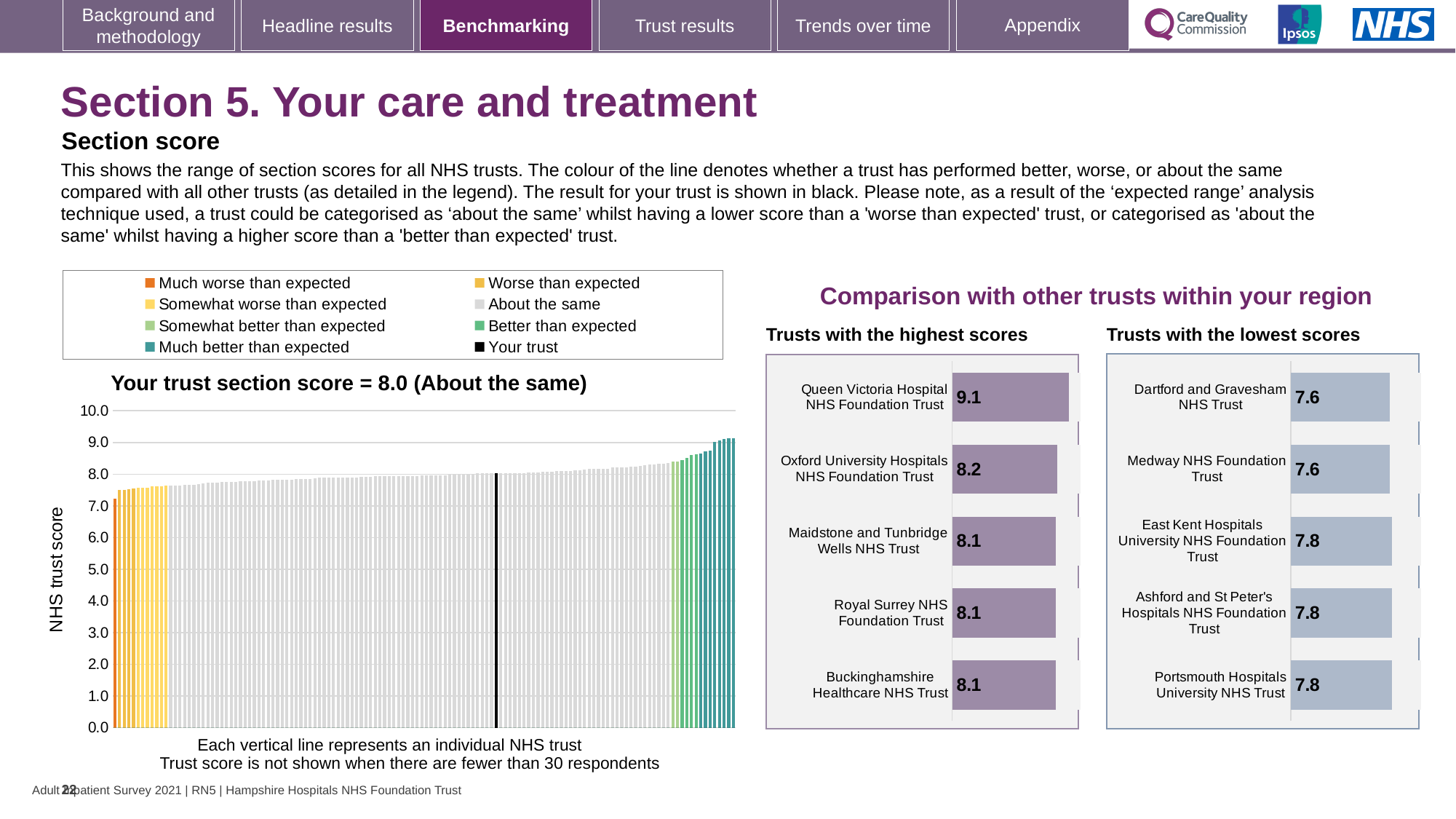
What kind of chart is the main chart showing the range of section scores for all NHS trusts? bar chart In the 'Trusts with the lowest scores' chart, what is the difference between the scores of East Kent Hospitals University NHS Foundation Trust and Dartford and Gravesham NHS Trust? 0.2 In the main chart 'Your trust section score', what is the section score for your trust? 8.0 How many entries does the legend above the main chart list? 8 In the 'Trusts with the highest scores' chart, what is the score for Queen Victoria Hospital NHS Foundation Trust? 9.1 In the main chart, is the lowest trust score greater or less than 8.0? less In the 'Trusts with the lowest scores' chart, what is the score for Portsmouth Hospitals University NHS Trust? 7.8 In the 'Trusts with the highest scores' chart, what is the difference between the scores of Queen Victoria Hospital NHS Foundation Trust and Oxford University Hospitals NHS Foundation Trust? 0.9 In the main chart 'Your trust section score', which category does your trust fall into according to the title? About the same In the 'Trusts with the highest scores' chart, which trust has the highest score? Queen Victoria Hospital NHS Foundation Trust In the 'Trusts with the highest scores' chart, which has the larger score, Oxford University Hospitals NHS Foundation Trust or Maidstone and Tunbridge Wells NHS Trust? Oxford University Hospitals NHS Foundation Trust In the 'Trusts with the highest scores' chart, how many trusts are shown? 5